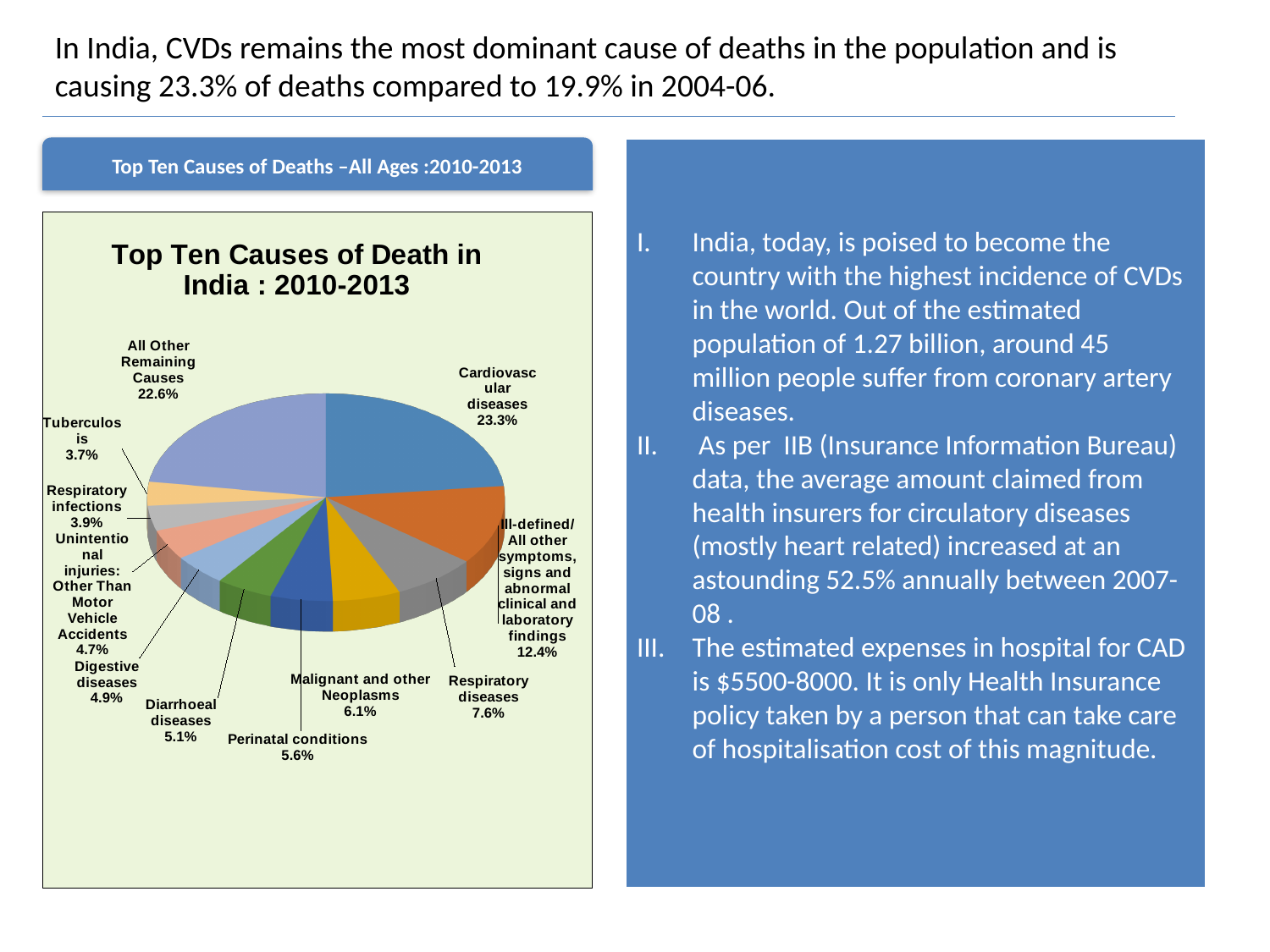
What kind of chart is shown on the slide? Pie chart Which named cause of death has the largest slice in the pie chart? Cardiovascular diseases What share of deaths is attributed to Cardiovascular diseases in the pie chart? 23.3% What percentage does the pie chart show for Respiratory diseases? 7.6% What is the value shown for Tuberculosis in the pie chart? 3.7% How many slices does the pie chart contain? 11 What is the combined share of Respiratory infections and Respiratory diseases? 11.5% What percentage is shown for Perinatal conditions? 5.6% What is the difference between the Cardiovascular diseases share and the Ill-defined/All other symptoms share? 10.9% What is the title of the pie chart? Top Ten Causes of Death in India : 2010-2013 Which slice in the pie chart has the smallest percentage? Tuberculosis Which is larger: the share for Diarrhoeal diseases or the share for Digestive diseases? Diarrhoeal diseases